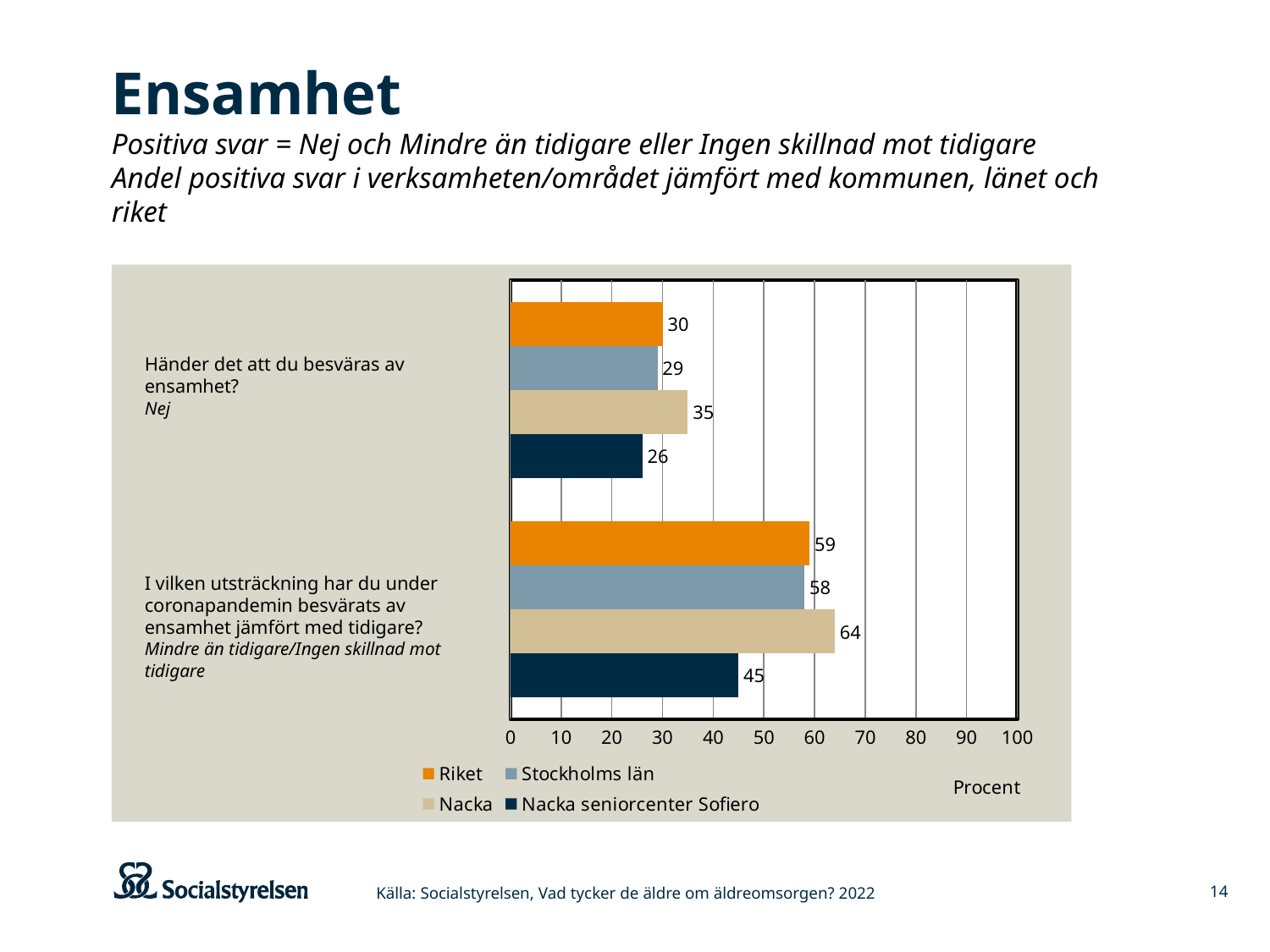
What is the value for Nacka for the question "Händer det att du besväras av ensamhet?"? 35 How many series does the legend list? 4 Which series has the lowest value for the question "I vilken utsträckning har du under coronapandemin besvärats av ensamhet jämfört med tidigare?"? Nacka seniorcenter Sofiero What is the value for Nacka seniorcenter Sofiero for the question "I vilken utsträckning har du under coronapandemin besvärats av ensamhet jämfört med tidigare?"? 45 What is the label of the x axis? Procent Which is larger for the question "Händer det att du besväras av ensamhet?": Riket or Nacka seniorcenter Sofiero? Riket Is the value for Nacka for the question "I vilken utsträckning har du under coronapandemin besvärats av ensamhet jämfört med tidigare?" greater or less than 60? greater What is the value for Riket for the question "I vilken utsträckning har du under coronapandemin besvärats av ensamhet jämfört med tidigare?"? 59 What kind of chart is shown on the slide? Bar chart How many question categories are shown on the chart? 2 What is the difference between Nacka and Nacka seniorcenter Sofiero for the question "I vilken utsträckning har du under coronapandemin besvärats av ensamhet jämfört med tidigare?"? 19 Which series has the highest value for the question "Händer det att du besväras av ensamhet?"? Nacka